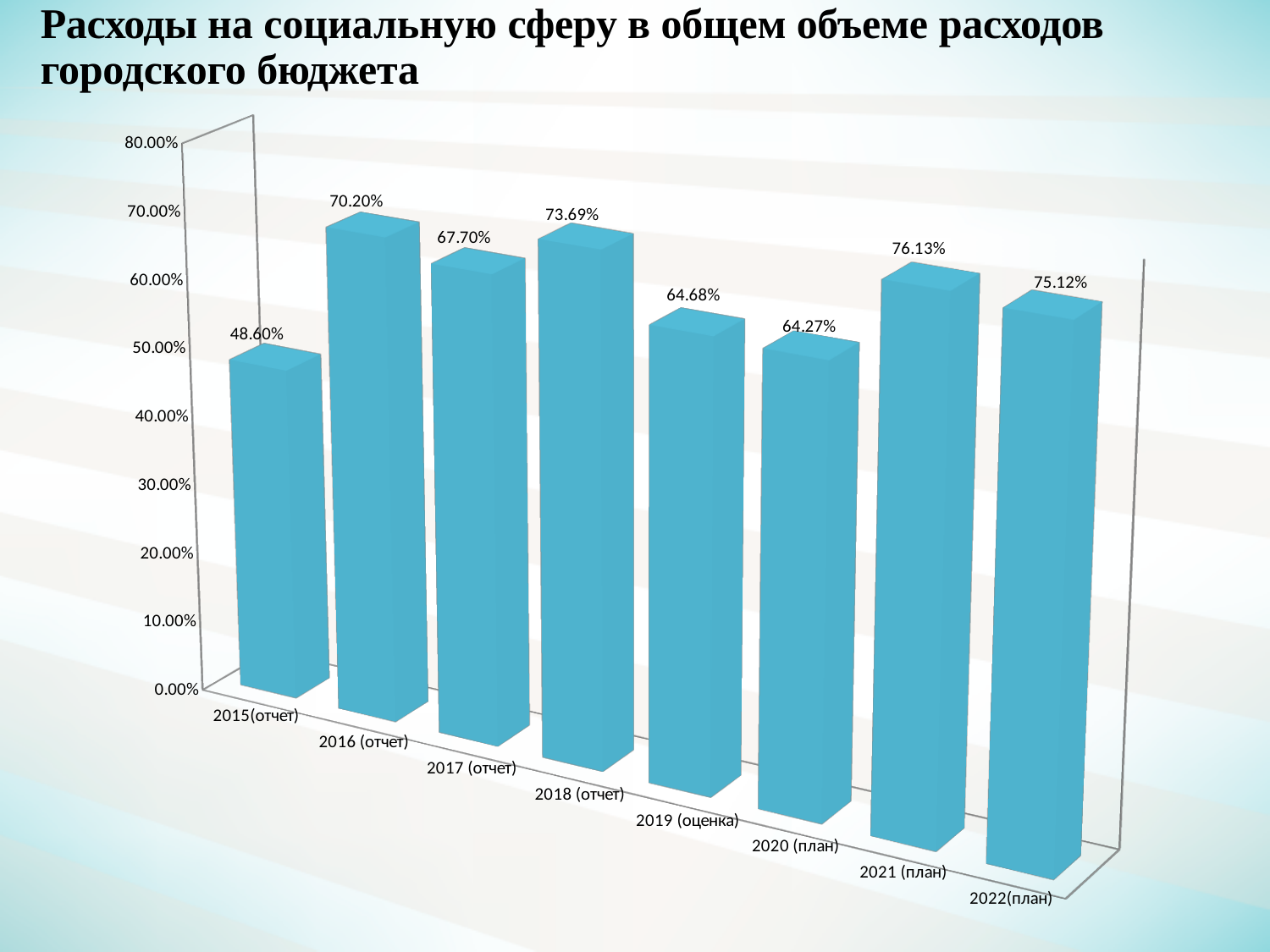
What is the title of the chart? Расходы на социальную сферу в общем объеме расходов городского бюджета Is the value for 2015 (отчет) greater or less than 50.00%? less What kind of chart is shown on the slide? bar chart What is the difference between the values for 2016 (отчет) and 2017 (отчет)? 2.50% Which category has the highest value? 2021 (план) How many categories are shown on the x axis? 8 What is the value for 2020 (план)? 64.27% What is the value for 2015 (отчет)? 48.60% Which is larger, the value for 2019 (оценка) or the value for 2020 (план)? 2019 (оценка) What is the value for 2022 (план)? 75.12% What is the value for 2018 (отчет)? 73.69% Which category has the lowest value? 2015 (отчет)